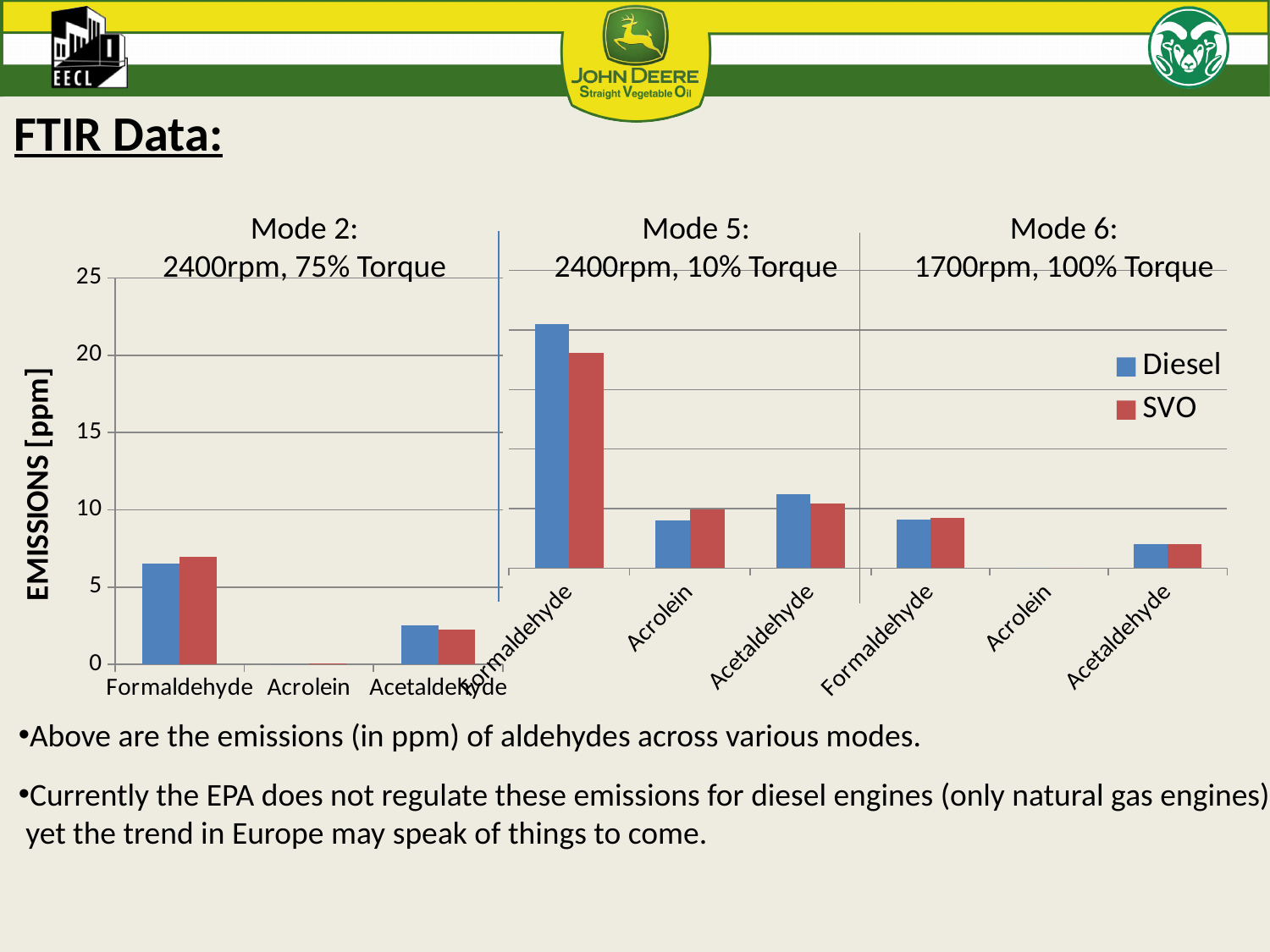
How many aldehyde categories are plotted for each mode? 3 What is the label on the vertical axis of the chart? EMISSIONS [ppm] Is the Diesel value for Formaldehyde in Mode 2 greater or less than 10? less How many series does the chart legend list? 2 For Formaldehyde in Mode 5, which series has the larger value, Diesel or SVO? Diesel Is the SVO value for Formaldehyde in Mode 5 greater or less than 15? greater What kind of chart is shown on the slide? bar chart What are the two series named in the chart legend? Diesel and SVO Which mode and compound has the highest Diesel emission bar in the chart? Formaldehyde in Mode 5 How many engine modes are shown in the chart? 3 Which compound has the lowest emissions in Mode 6? Acrolein